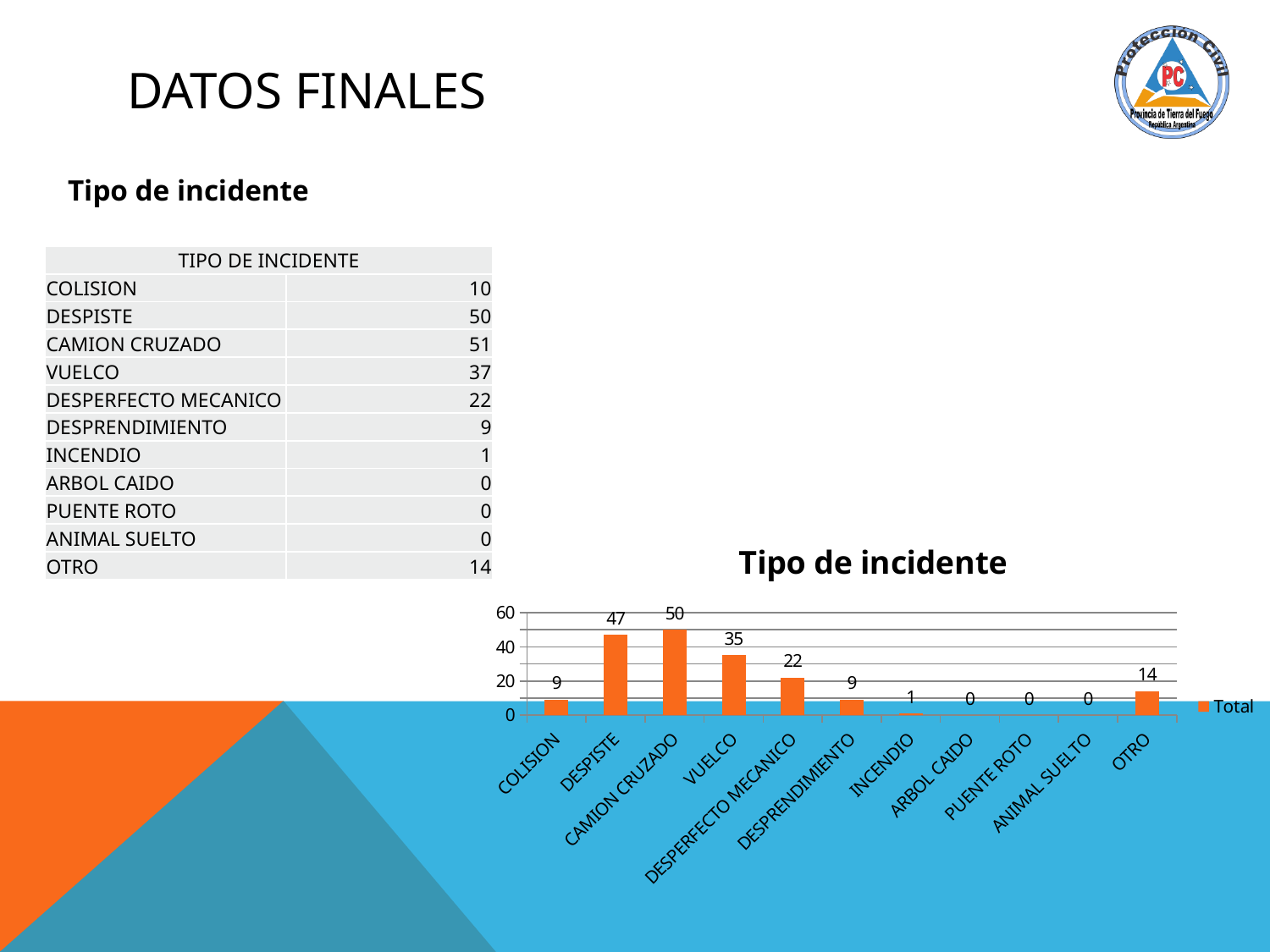
In the chart, what is the value for INCENDIO? 1 What kind of chart is shown on the slide? Bar chart How many categories are shown on the x axis of the chart? 11 In the chart, what is the value for DESPISTE? 47 How many series does the chart's legend list? 1 In the chart, which is larger, the value for VUELCO or the value for OTRO? VUELCO In the chart, what is the value for OTRO? 14 In the chart, what is the difference between the values for CAMION CRUZADO and DESPISTE? 3 Which category has the highest value in the chart? CAMION CRUZADO In the chart, what is the value for CAMION CRUZADO? 50 In the chart, what is the value for VUELCO? 35 In the chart, what is the difference between the values for VUELCO and DESPERFECTO MECANICO? 13